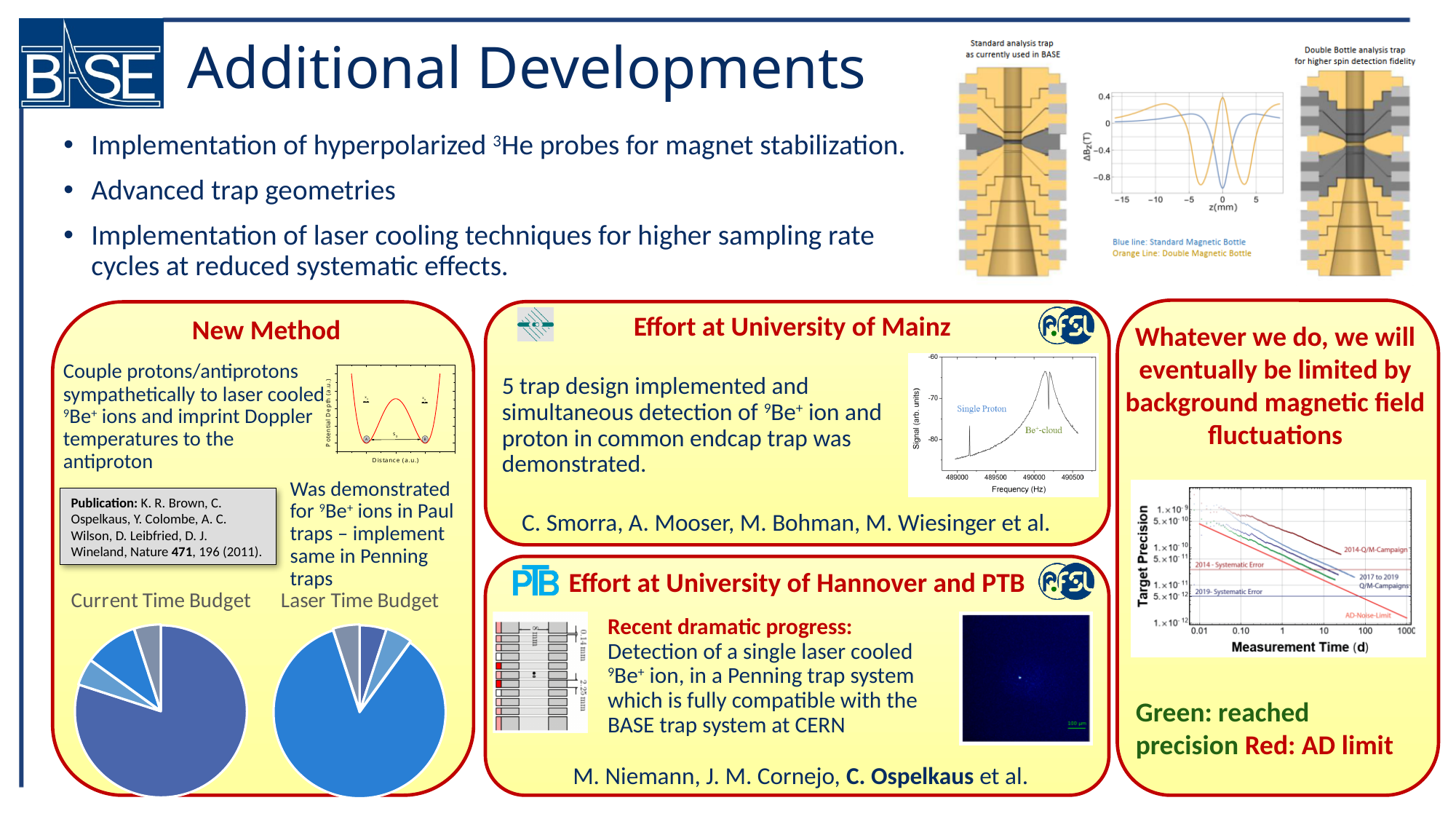
Which pie chart has the larger dominant slice, "Current Time Budget" or "Laser Time Budget"? Laser Time Budget In the "Laser Time Budget" pie chart, what colour is the largest slice? Blue What kind of chart is the "Current Time Budget" chart? Pie chart How many slices does the "Laser Time Budget" pie chart have? 4 In the "Current Time Budget" pie chart, what colour is the largest slice? Dark blue What are the titles of the two pie charts in the "New Method" box? Current Time Budget and Laser Time Budget How many slices does the "Current Time Budget" pie chart have? 4 What kind of chart is the "Laser Time Budget" chart? Pie chart Which pie chart is positioned on the left in the "New Method" box? Current Time Budget